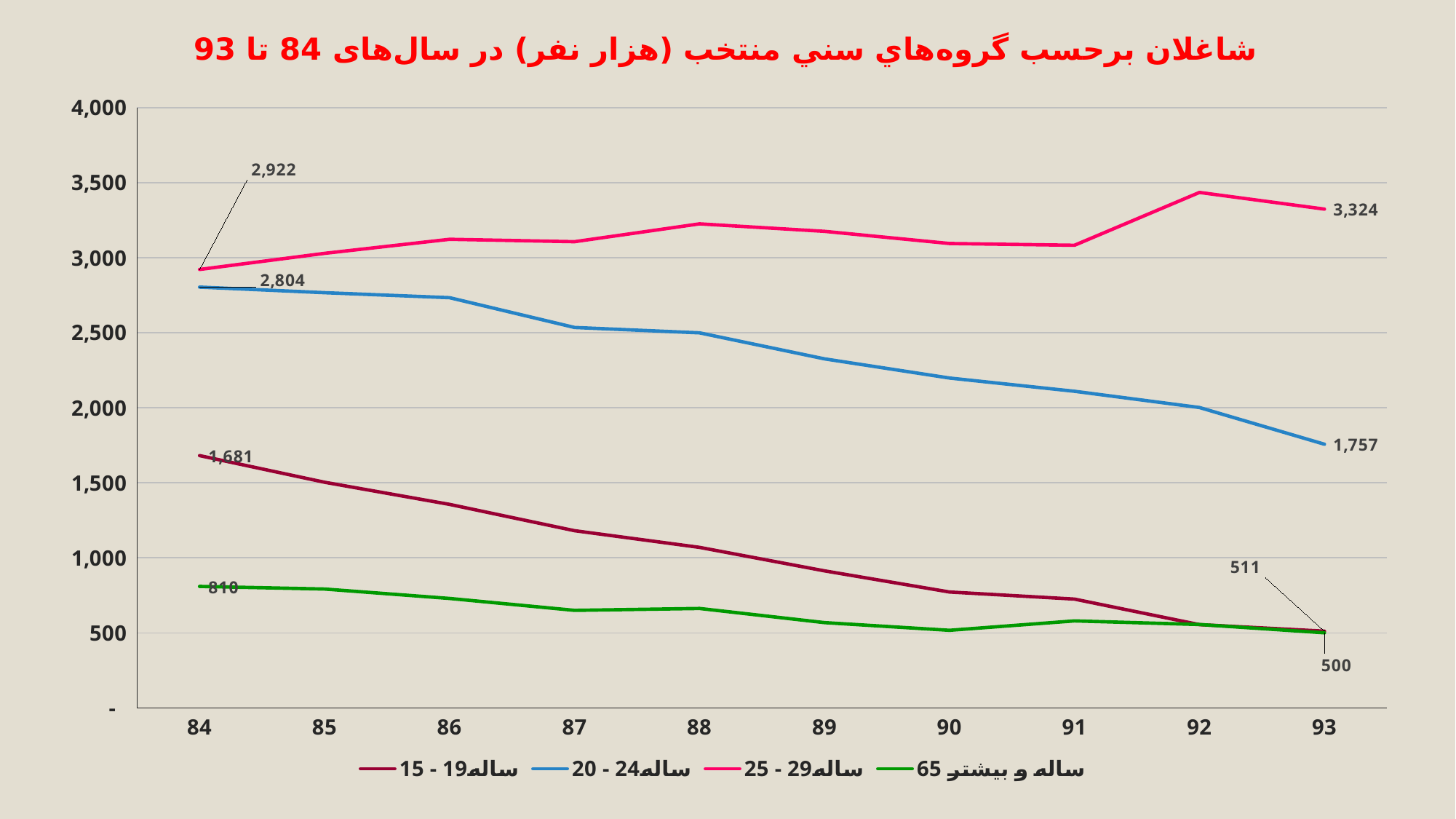
What type of chart is shown on the slide? line chart What is the value for the 20 - 24 ساله series in year 93? 1,757 Does the 15 - 19 ساله series rise or fall from year 84 to year 93? fall Which series has the lowest value in year 84? 65 ساله و بیشتر What is the difference between the 20 - 24 ساله values in year 84 and year 93? 1,047 How many series does the legend list? 4 What is the value for the 25 - 29 ساله series in year 84? 2,922 Which series has the highest value in year 93? 25 - 29 ساله Is the value for the 20 - 24 ساله series in year 88 greater or less than 2,000? greater What is the value for the 65 ساله و بیشتر series in year 93? 500 How many years are shown on the x axis? 10 What is the value for the 15 - 19 ساله series in year 84? 1,681